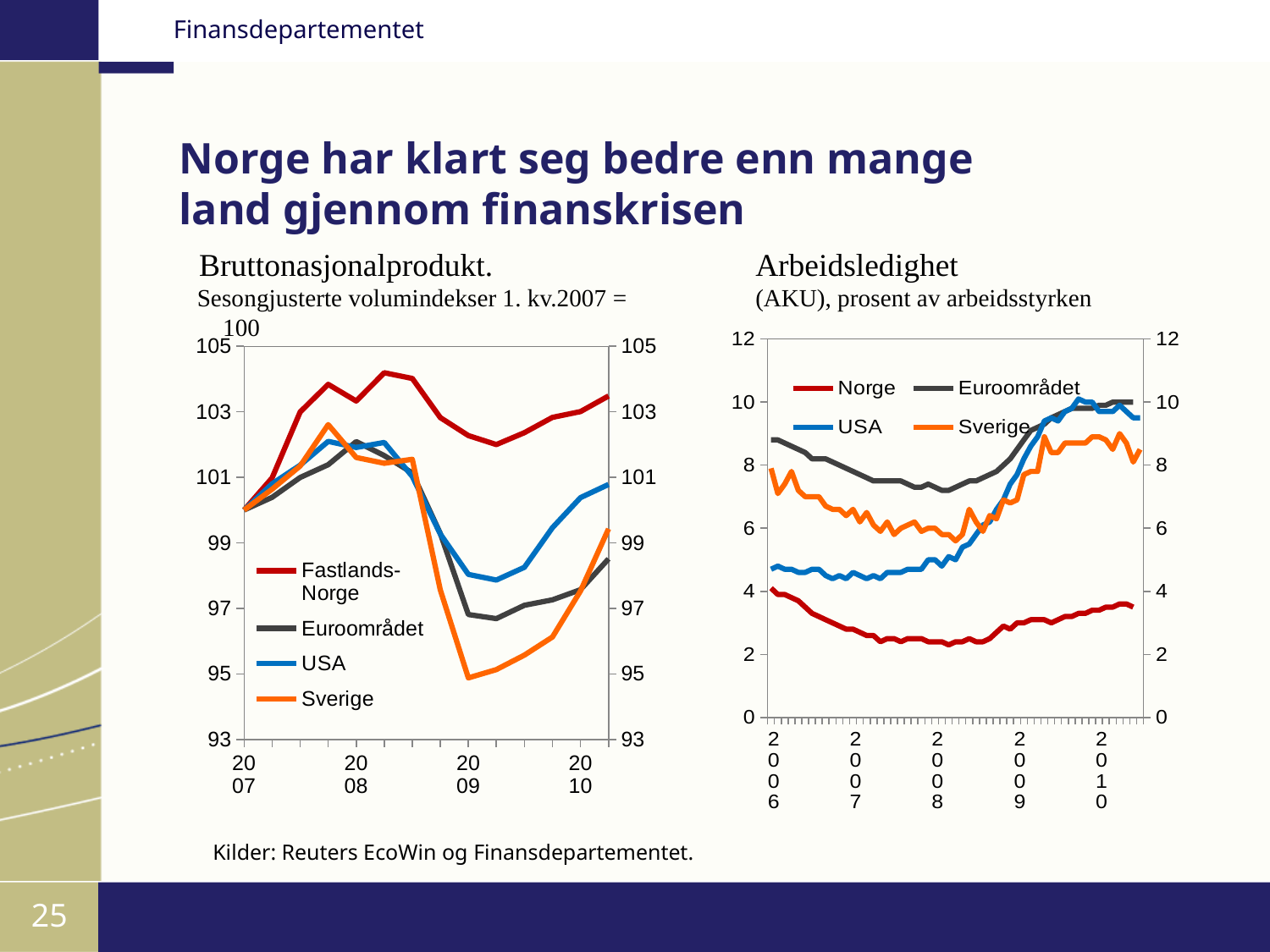
In the Bruttonasjonalprodukt chart, is the peak value for Fastlands-Norge in 2008 greater or less than 103? greater How many series does the legend of the Arbeidsledighet chart on the right list? 4 What kind of chart is the Bruttonasjonalprodukt chart on the left? line chart In the Bruttonasjonalprodukt chart, which series stays highest through 2009 and 2010? Fastlands-Norge In the Arbeidsledighet chart, at the end of 2010, which is higher: Sverige or Norge? Sverige In the Bruttonasjonalprodukt chart, is the lowest value for Sverige greater or less than 97? less In the Arbeidsledighet chart, which series has the lowest unemployment rate throughout the period? Norge In the Arbeidsledighet chart, is the value for Norge at the end of 2010 greater or less than 4? less In the Bruttonasjonalprodukt chart, which series falls to the lowest level in 2009? Sverige In the Bruttonasjonalprodukt chart, does the USA series rise or fall from 2009 to 2010? rise In the Arbeidsledighet chart, which series has the highest unemployment rate at the start of 2006? Euroområdet